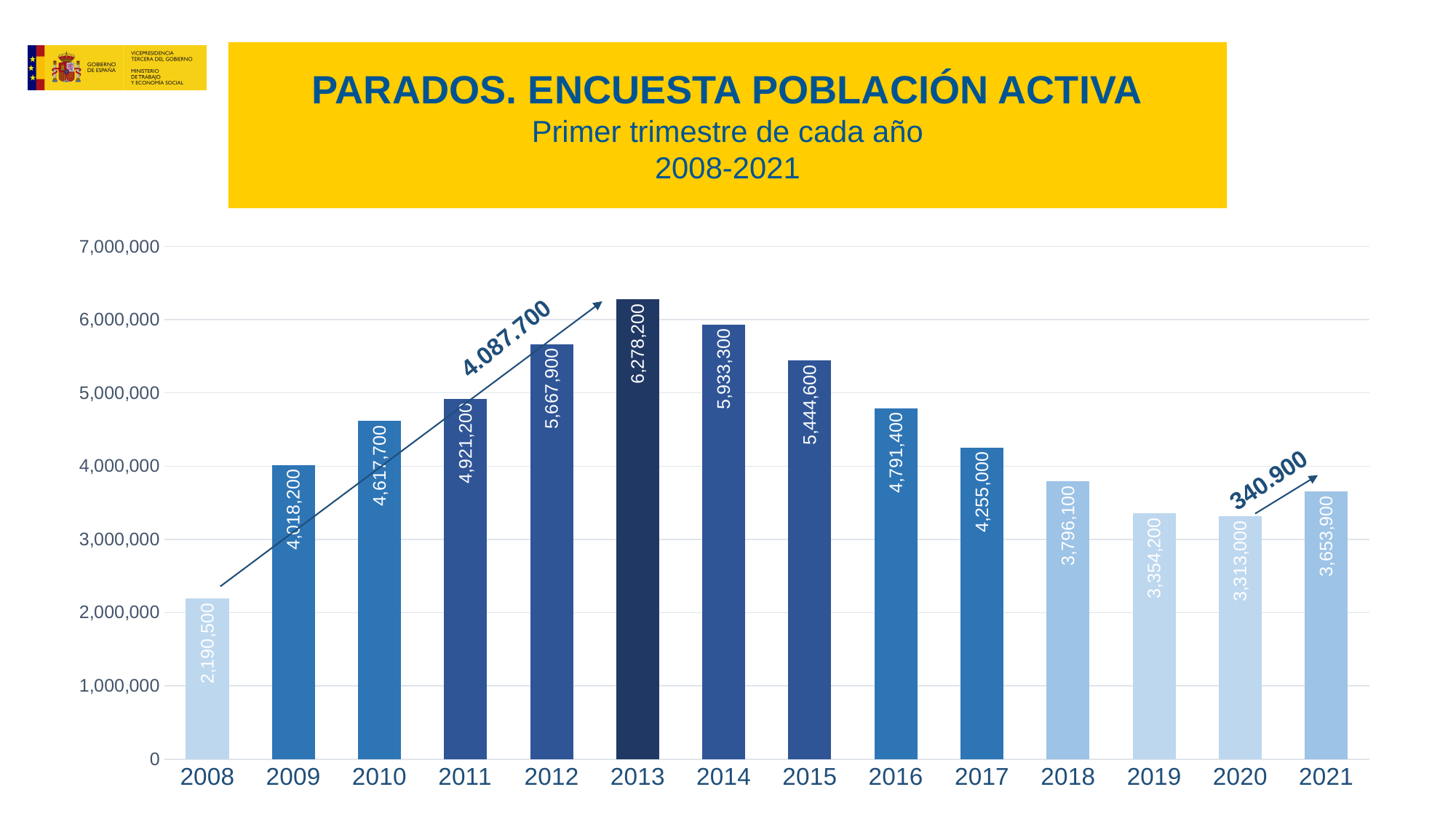
Which year has the highest value? 2013 Is the value for 2017 greater or less than 4,000,000? greater Which is larger, the value for 2014 or the value for 2015? 2014 What kind of chart is shown on the slide? bar chart What is the value for 2008? 2,190,500 Which year has the lowest value? 2008 What is the value for 2013? 6,278,200 How many years are shown on the x axis? 14 What is the difference between the values for 2013 and 2008? 4,087,700 What is the difference between the values for 2021 and 2020? 340,900 Do the values rise or fall from 2013 to 2020? fall What is the value for 2020? 3,313,000